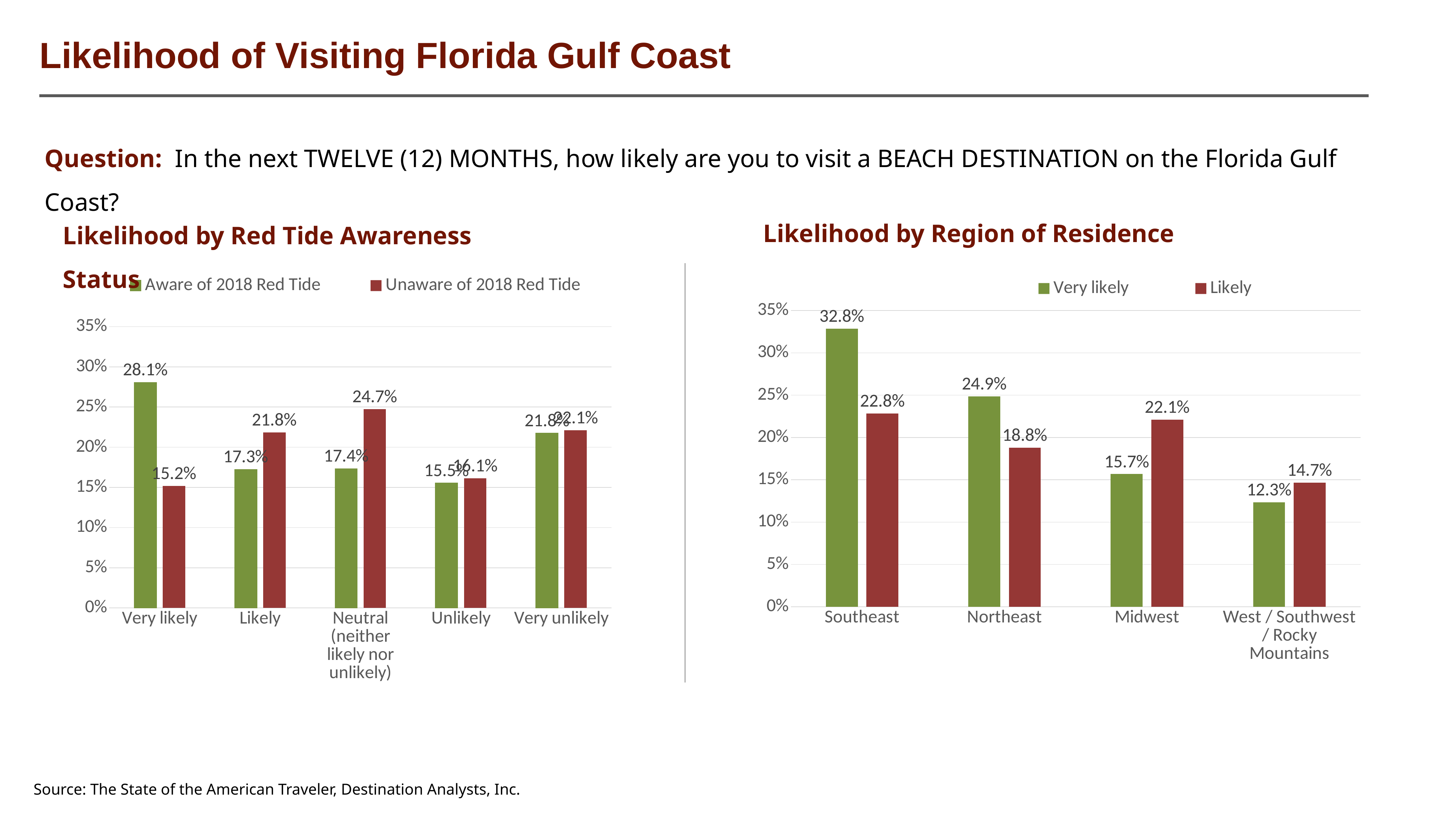
In the 'Likelihood by Red Tide Awareness Status' chart, how many categories are shown on the x axis? 5 What type of chart is the 'Likelihood by Region of Residence' chart? Bar chart In the 'Likelihood by Red Tide Awareness Status' chart, what percentage of those aware of the 2018 Red Tide said they are very likely to visit? 28.1% In the 'Likelihood by Red Tide Awareness Status' chart, what is the difference between the Aware and Unaware values for Very likely? 12.9% In the 'Likelihood by Red Tide Awareness Status' chart, which category has the highest value for Aware of 2018 Red Tide? Very likely In the 'Likelihood by Region of Residence' chart, what is the difference between the Very likely and Likely values for Southeast? 10.0% In the 'Likelihood by Region of Residence' chart, what is the Very likely value for Southeast? 32.8% In the 'Likelihood by Region of Residence' chart, what is the Likely value for Midwest? 22.1% In the 'Likelihood by Region of Residence' chart, which region has the lowest Very likely value? West / Southwest / Rocky Mountains In the 'Likelihood by Red Tide Awareness Status' chart, what is the value for Unaware of 2018 Red Tide in the Neutral category? 24.7% In the 'Likelihood by Red Tide Awareness Status' chart, how many series does the legend list? 2 In the 'Likelihood by Region of Residence' chart, is the Very likely value for Northeast larger or the Likely value for Northeast? Very likely